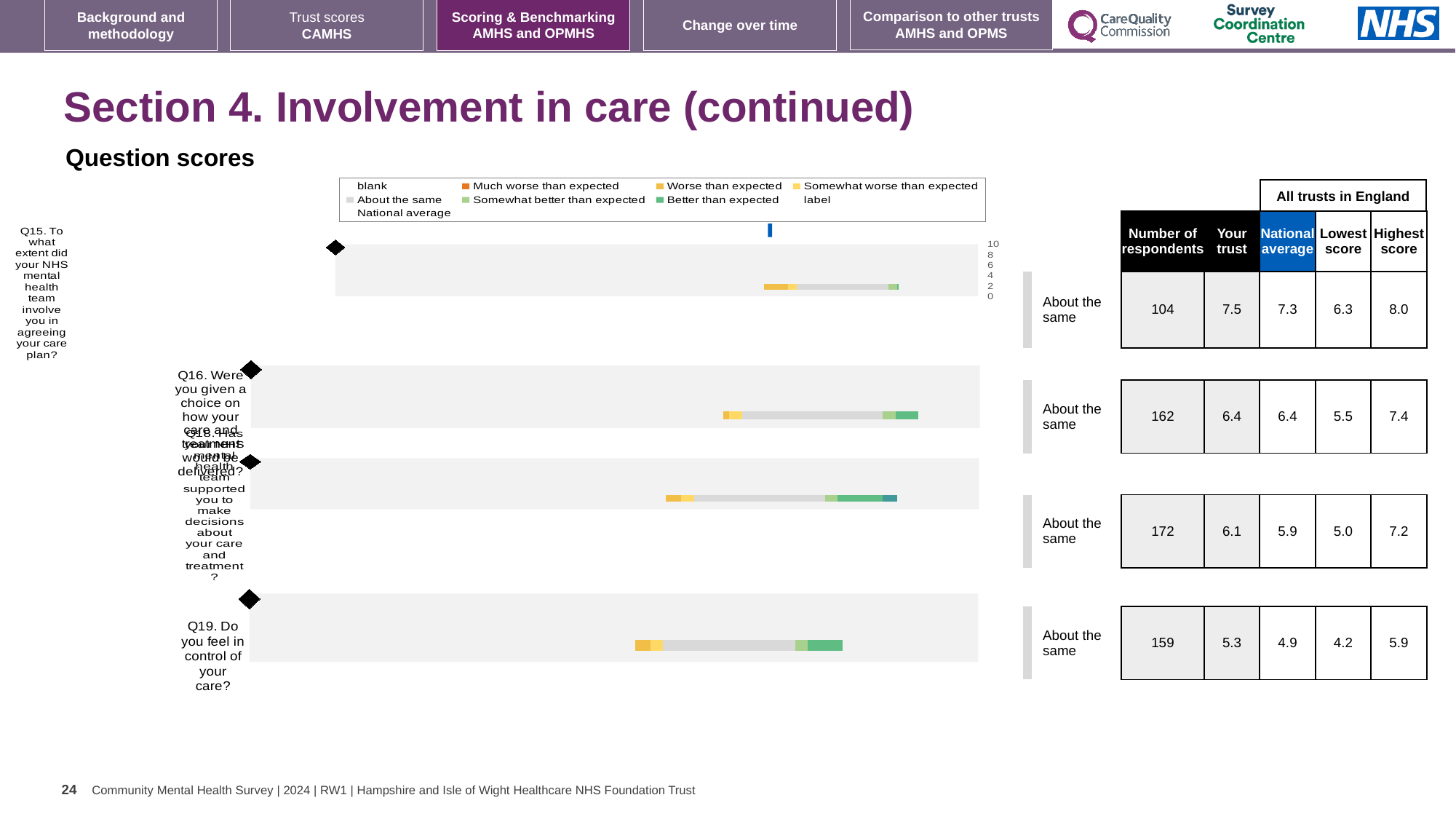
What is the 'Your trust' score for Q15 (To what extent did your NHS mental health team involve you in agreeing your care plan?)? 7.5 What is the national average score for Q19 (Do you feel in control of your care?)? 4.9 Which question has the highest 'Your trust' score on this slide? Q15 Which question has the lowest 'Your trust' score on this slide? Q19 For Q15, what is the difference between the highest score and the lowest score among all trusts in England? 1.7 What is the highest score among all trusts in England for Q16 (Were you given a choice on how your care and treatment would be delivered?)? 7.4 For Q19, which is larger: the 'Your trust' score or the national average? Your trust How many respondents answered Q18 (Has your NHS mental health team supported you to make decisions about your care and treatment?)? 172 For Q18, what is the difference between the 'Your trust' score and the national average? 0.2 What benchmark category is shown for each of the four questions on this slide? About the same How many questions are shown in the question scores chart on this slide? 4 What kind of chart is used to show the question scores? Bar chart